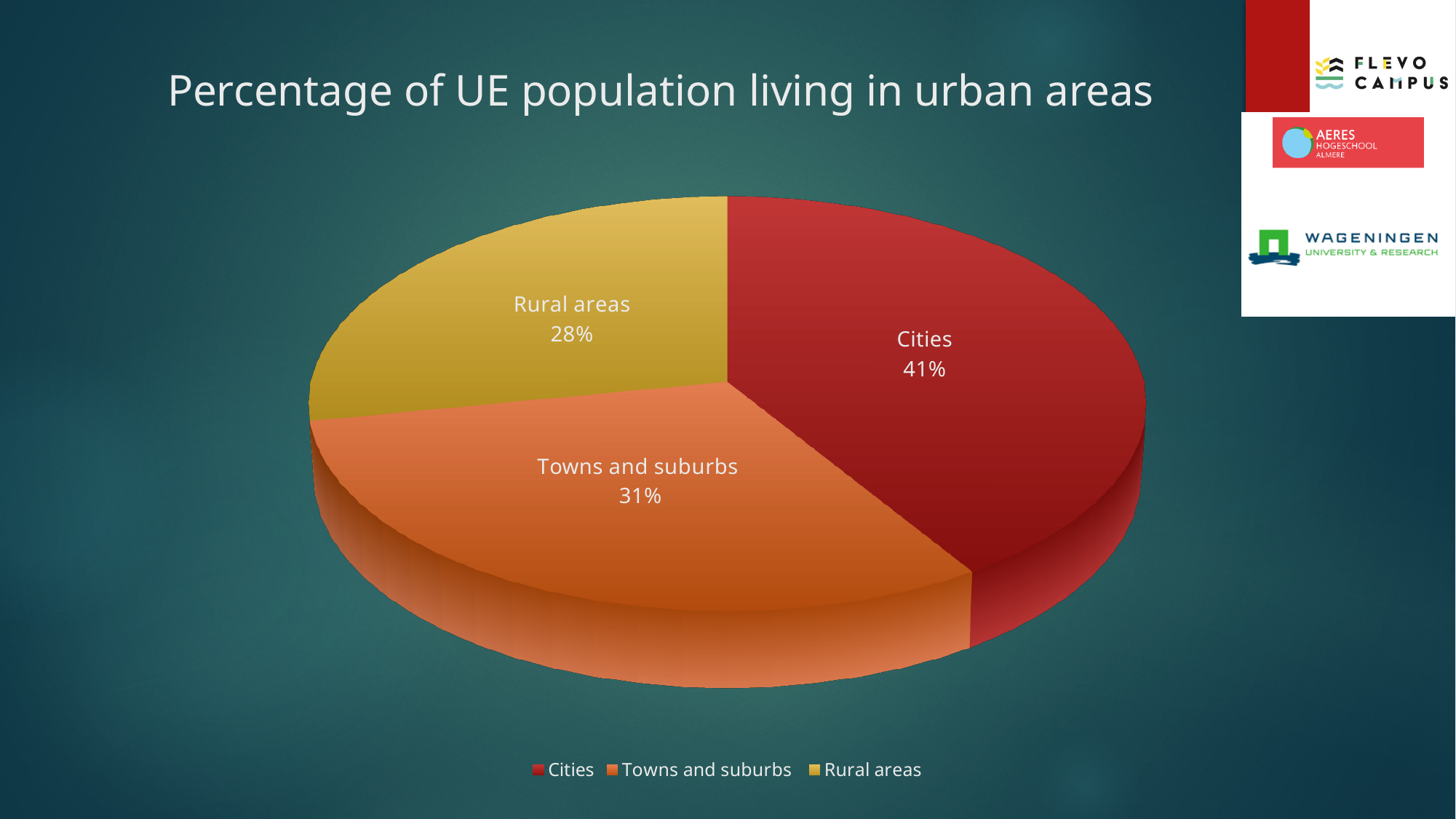
Which is larger, the share for Cities or the share for Towns and suburbs? Cities What colour is the Rural areas slice? Yellow What is the title of the chart? Percentage of UE population living in urban areas What percentage of the pie is labelled for Cities? 41% What kind of chart is shown on the slide? Pie chart What percentage is shown for Rural areas? 28% What is the difference in percentage points between Towns and suburbs and Rural areas? 3 How many slices does the pie chart have? 3 What is the difference in percentage points between Cities and Rural areas? 13 Which category has the smallest slice of the pie? Rural areas Which category has the largest slice of the pie? Cities What percentage is shown for Towns and suburbs? 31%